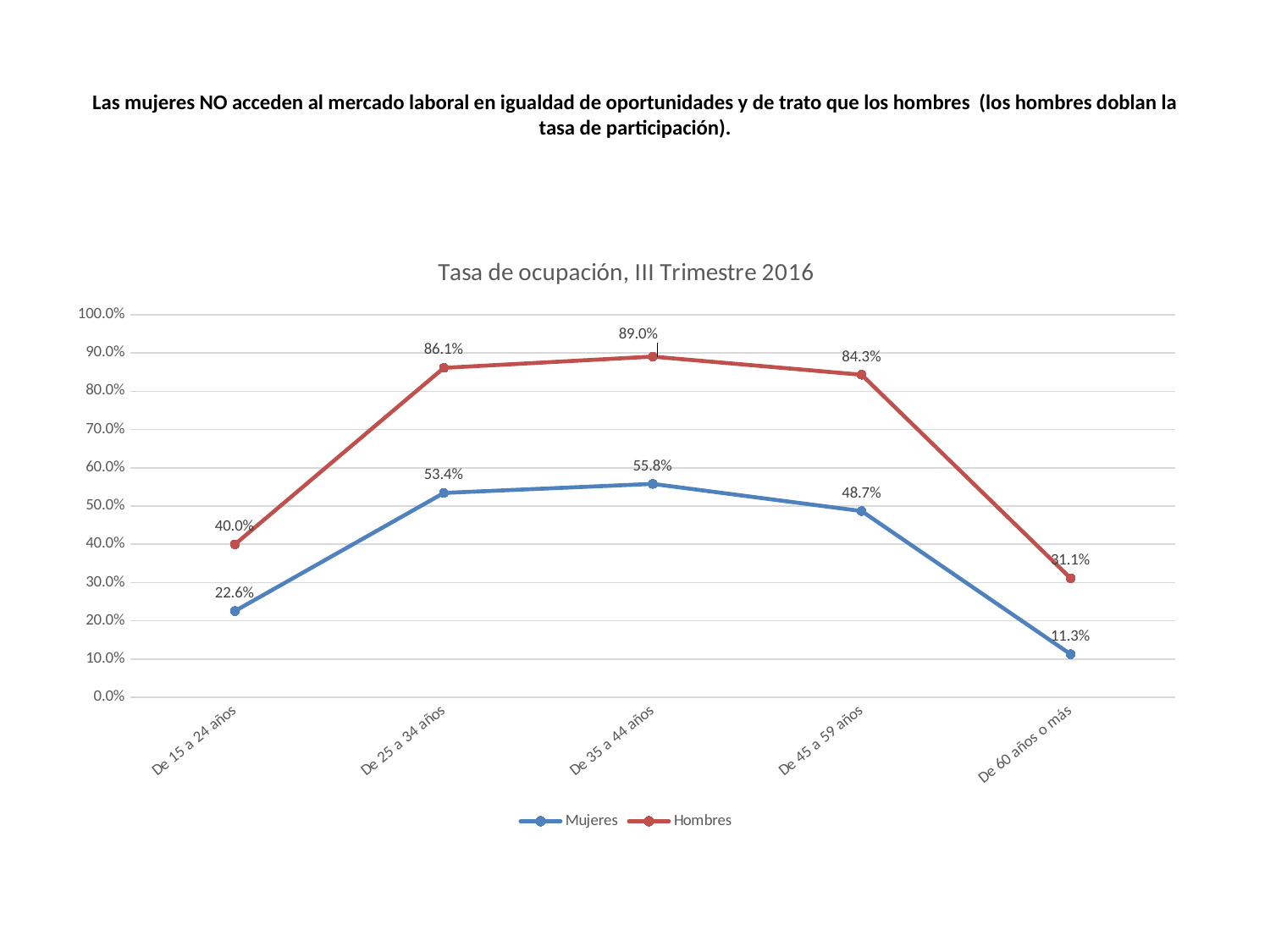
What is the difference between Hombres and Mujeres in the 'De 15 a 24 años' category? 17.4% Which age category has the lowest value for Mujeres? De 60 años o más What is the value for Mujeres in the 'De 25 a 34 años' category? 53.4% Which is larger in the 'De 45 a 59 años' category, Mujeres or Hombres? Hombres How many series does the legend list? 2 What is the title of the chart? Tasa de ocupación, III Trimestre 2016 Is the value for Mujeres in 'De 35 a 44 años' greater or less than 50.0%? greater Does the Hombres series rise or fall between 'De 45 a 59 años' and 'De 60 años o más'? Fall How many age categories are shown on the x axis? 5 What is the value for Hombres in the 'De 60 años o más' category? 31.1% Which age category has the highest value for Hombres? De 35 a 44 años What kind of chart is shown on the slide? Line chart